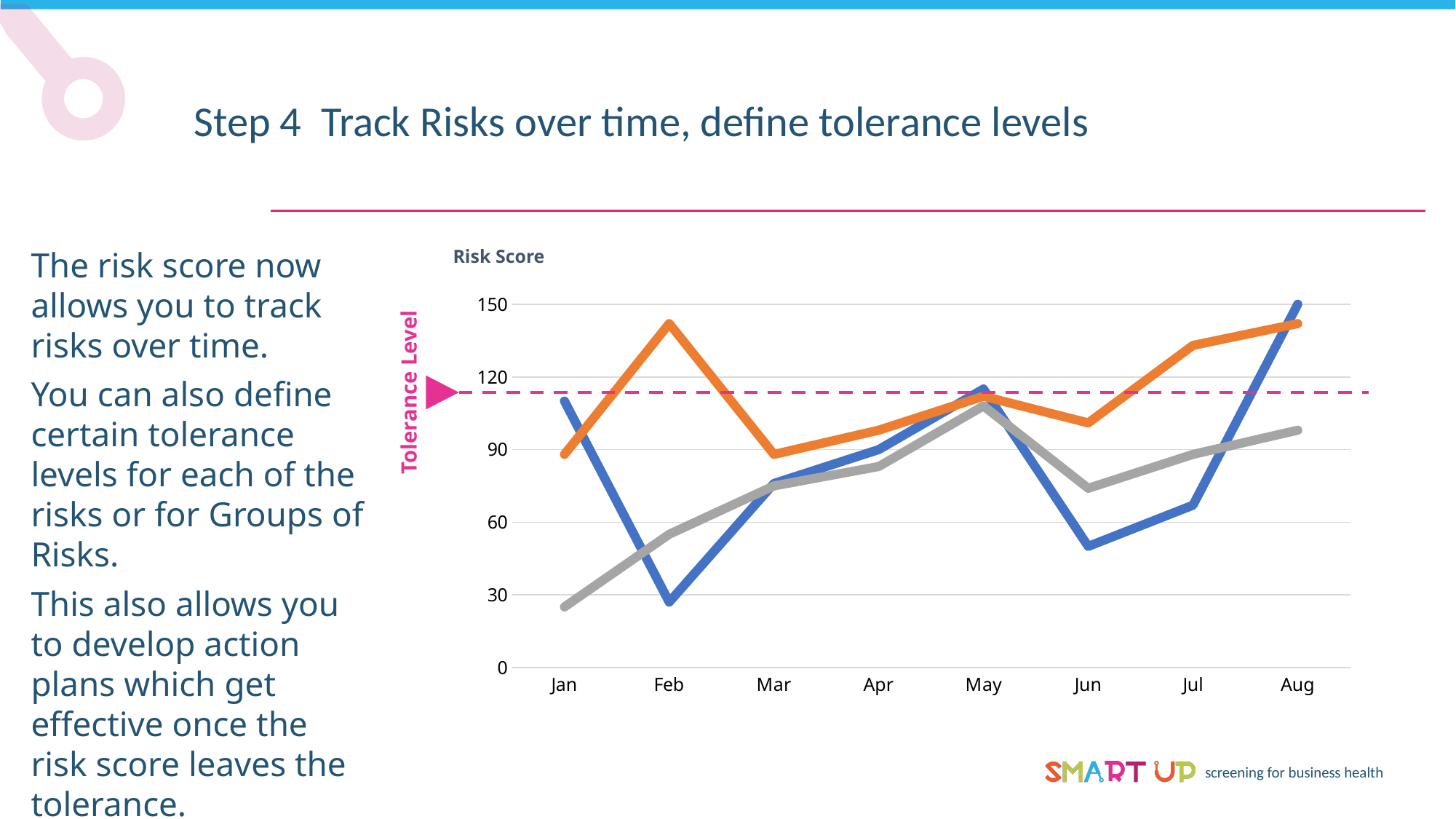
Is the value of the gray line in Jan greater or less than 30? less What kind of chart is shown on the slide? line chart What is the title of the chart? Risk Score Is the value of the blue line in Jun greater or less than 60? less In which month does the blue line reach its highest value? Aug Is the value of the orange line in Feb greater or less than 120? greater Does the gray line rise or fall from Jan to May? rise What does the pink dashed horizontal line on the chart represent? Tolerance Level How many months are shown on the x axis of the chart? 8 In Feb, which line has the higher value, the orange line or the blue line? orange line In which month does the gray line reach its lowest value? Jan In which month does the blue line reach its lowest value? Feb